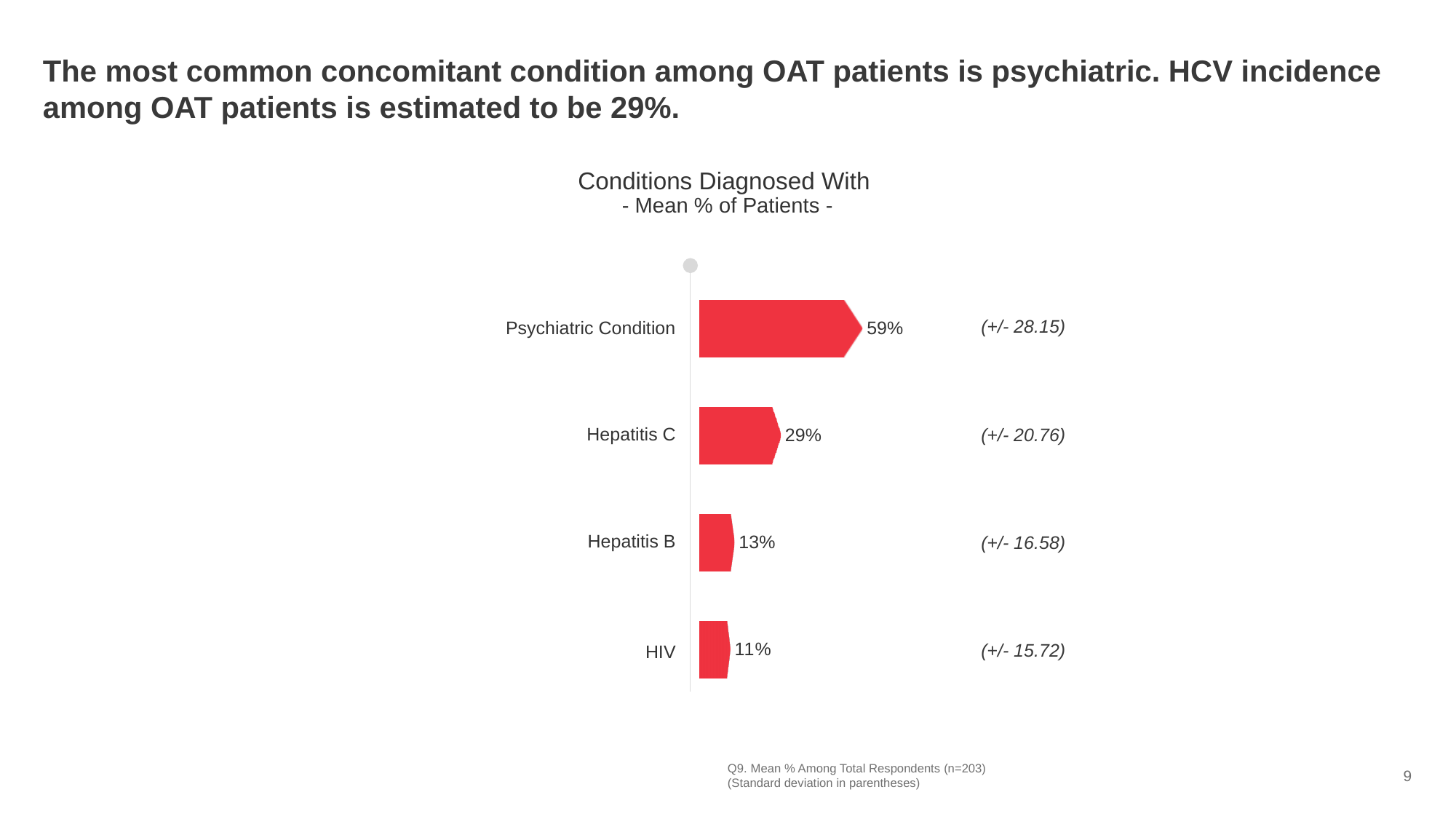
What type of chart is used to show the conditions diagnosed with? Bar chart What is the standard deviation shown in parentheses for Hepatitis C? (+/- 20.76) What is the mean % of patients diagnosed with Hepatitis C? 29% What is the mean % of patients diagnosed with a Psychiatric Condition? 59% What is the difference in mean % of patients between Psychiatric Condition and Hepatitis C? 30% What is the difference in mean % of patients between Hepatitis B and HIV? 2% Which condition has the highest mean % of patients? Psychiatric Condition Which has a higher mean % of patients, Hepatitis C or Hepatitis B? Hepatitis C How many conditions are shown in the chart? 4 What is the mean % of patients diagnosed with Hepatitis B? 13% Which condition has the lowest mean % of patients? HIV What is the mean % of patients diagnosed with HIV? 11%